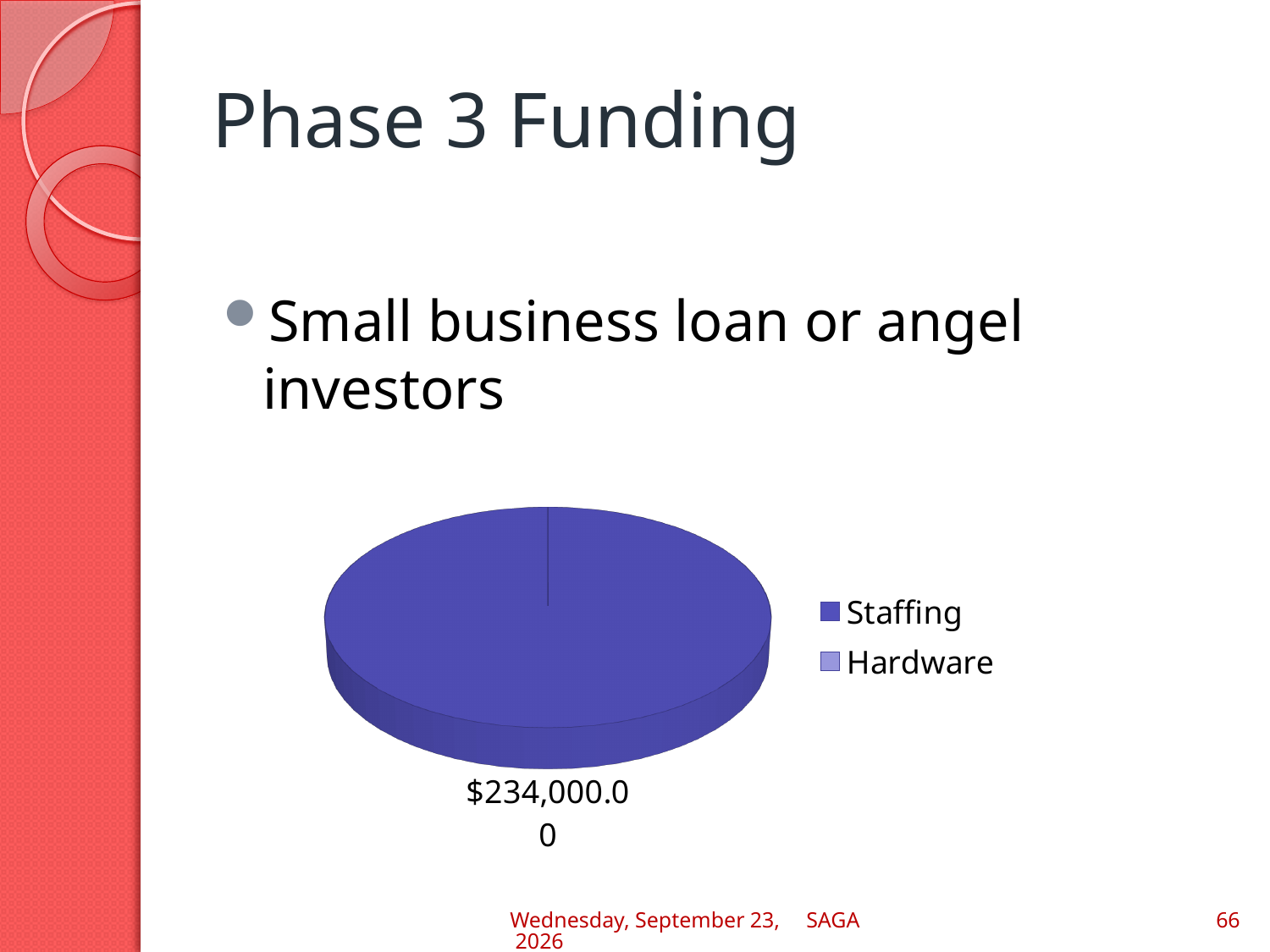
What kind of chart is shown on the slide? pie chart Is the value printed on the pie chart greater or less than $200,000? greater What are the two categories listed in the chart legend? Staffing and Hardware What value is printed as the data label on the pie chart? $234,000.00 Which legend entry is shown in the darker blue colour? Staffing Which is larger in the pie chart, Staffing or Hardware? Staffing Which category takes up the largest share of the pie chart? Staffing How many entries does the chart legend list? 2 Which category takes up the smallest share of the pie chart? Hardware